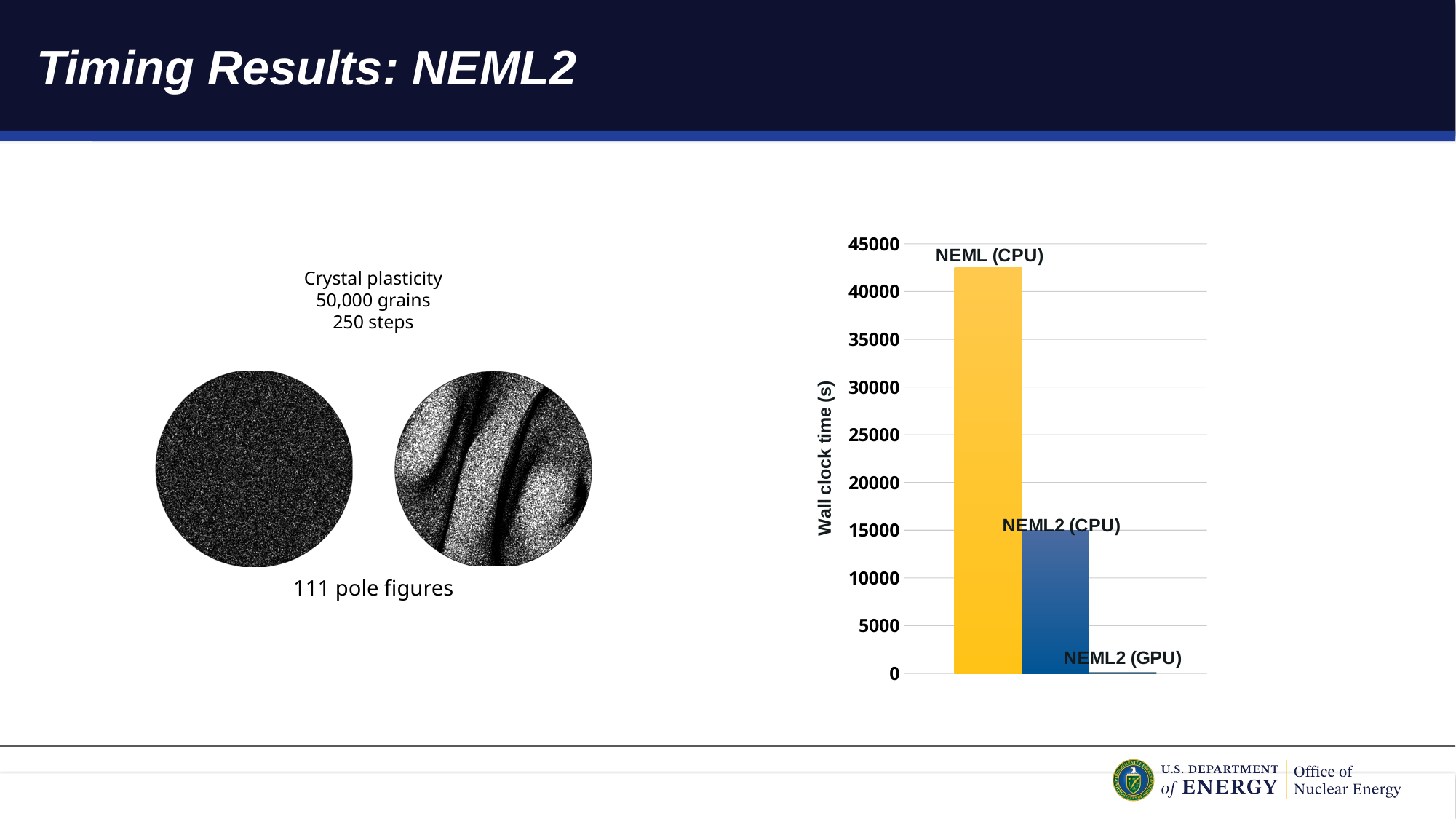
How many bars are plotted in the chart? 3 Is the value for NEML2 (CPU) greater or less than 20000? less Is the value for NEML (CPU) greater or less than 45000? less Which bar has the highest wall clock time? NEML (CPU) Is the value for NEML2 (CPU) greater or less than 10000? greater Which has a larger wall clock time, NEML (CPU) or NEML2 (CPU)? NEML (CPU) What is the label of the vertical axis of the chart? Wall clock time (s) Which has a larger wall clock time, NEML2 (CPU) or NEML2 (GPU)? NEML2 (CPU) What kind of chart is shown on the slide? bar chart Which bar has the lowest wall clock time? NEML2 (GPU)